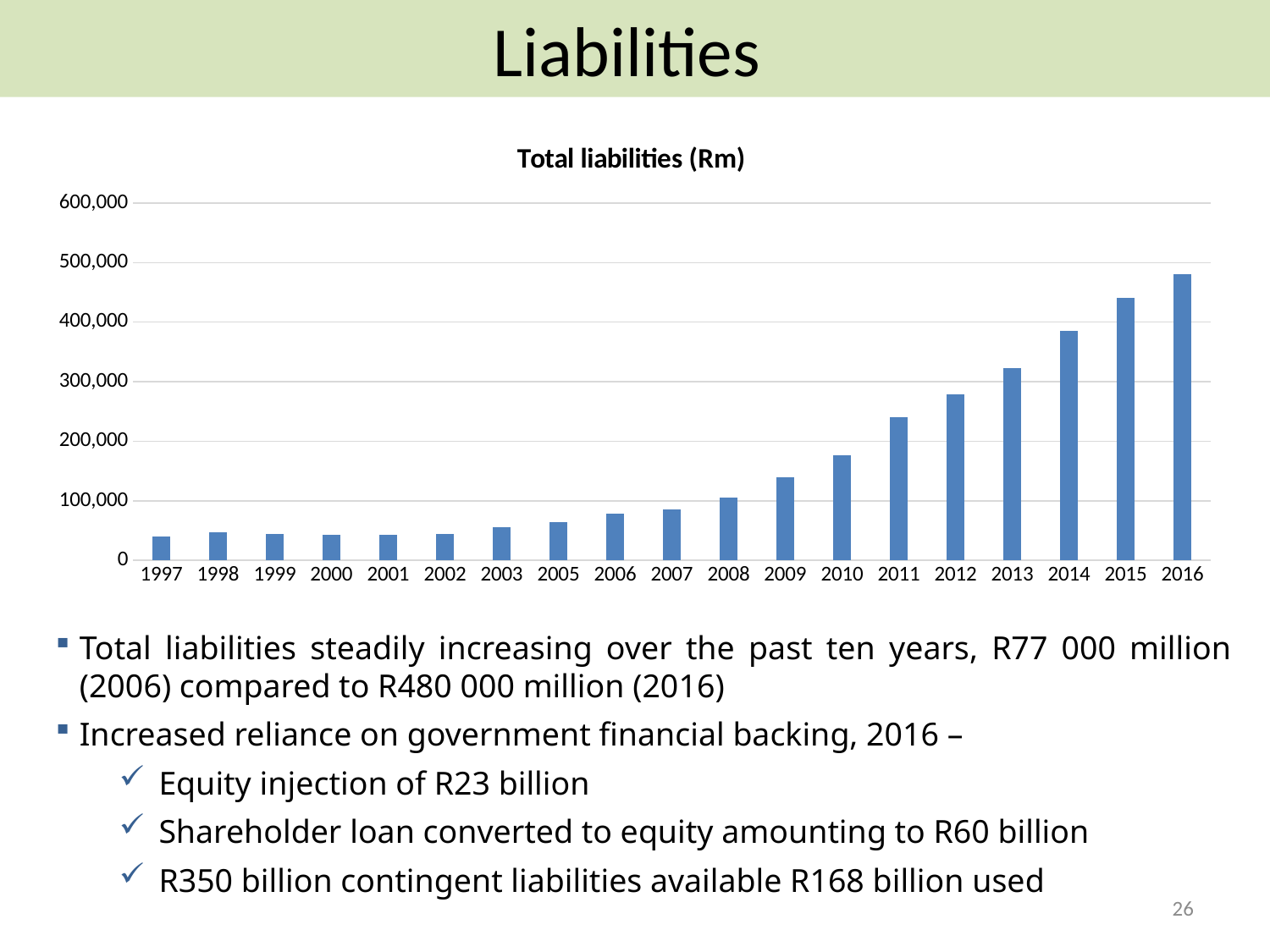
Do total liabilities generally rise or fall from 1997 to 2016 in the chart? Rise What is the title of the chart? Total liabilities (Rm) Which year has the highest total liabilities in the chart? 2016 Which year has the larger total liabilities, 2009 or 2010? 2010 Is the value for 2012 greater or less than 300,000? less Which year has the larger total liabilities, 2015 or 2016? 2016 How many years are plotted on the x axis of the chart? 19 Is the value for 2009 greater or less than 100,000? greater Is the value for 2013 greater or less than 300,000? greater What kind of chart is shown on the slide? Bar chart